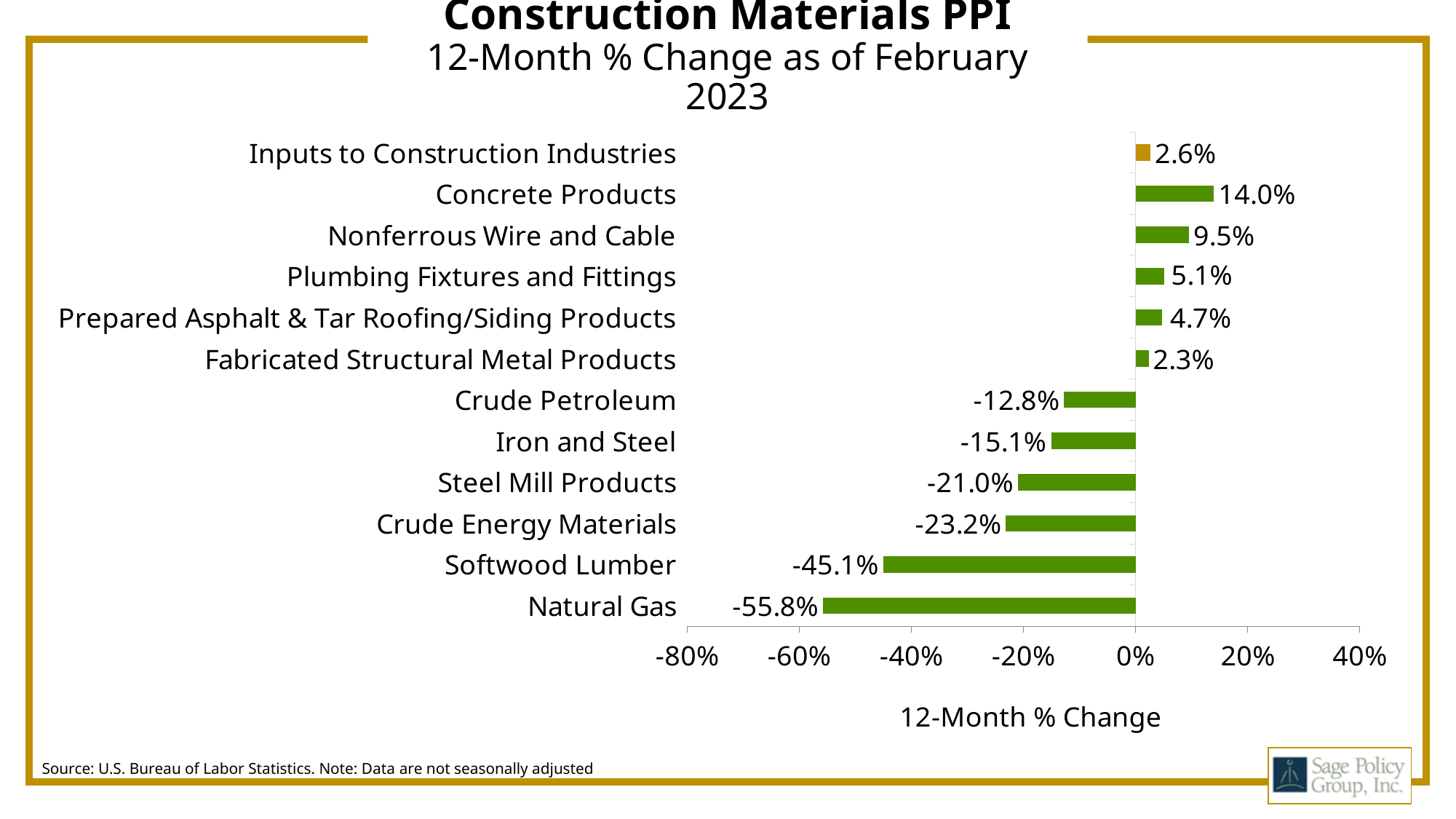
Which has a larger 12-month % change, Plumbing Fixtures and Fittings or Prepared Asphalt & Tar Roofing/Siding Products? Plumbing Fixtures and Fittings What is the 12-month % change for Iron and Steel? -15.1% Is the value for Softwood Lumber greater or less than -40%? less Which category has the lowest 12-month % change? Natural Gas How many categories are shown in the chart? 12 What kind of chart is shown on the slide? Bar chart What is the difference between the 12-month % change for Concrete Products and Nonferrous Wire and Cable? 4.5% Which category has the highest 12-month % change? Concrete Products What is the 12-month % change for Concrete Products? 14.0% What is the 12-month % change for Natural Gas? -55.8% What is the label of the horizontal axis? 12-Month % Change What is the 12-month % change for Inputs to Construction Industries? 2.6%